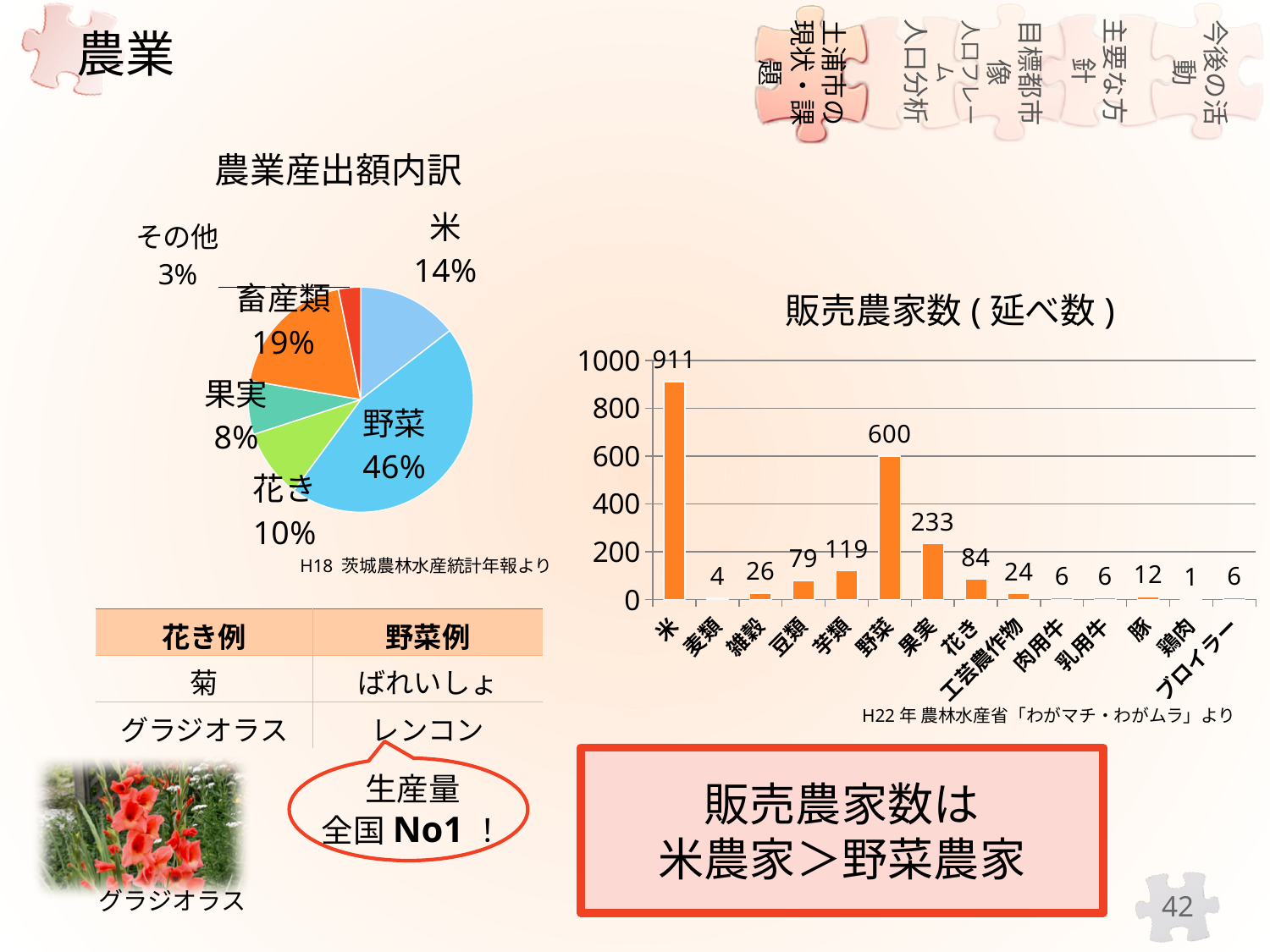
In the bar chart 販売農家数(延べ数), what is the value for 米? 911 In the bar chart 販売農家数(延べ数), which category has the highest value? 米 In the pie chart 農業産出額内訳, how many slices are there? 6 In the pie chart 農業産出額内訳, which category has the smallest share? その他 In the pie chart 農業産出額内訳, what share does 野菜 have? 46% In the pie chart 農業産出額内訳, what is the difference in percentage points between 米 and 果実? 6 In the bar chart 販売農家数(延べ数), which category has the lowest value? 鶏肉 In the bar chart 販売農家数(延べ数), what is the value for 果実? 233 In the bar chart 販売農家数(延べ数), how many categories are shown on the x axis? 14 In the bar chart 販売農家数(延べ数), what is the difference between 米 and 野菜? 311 In the pie chart 農業産出額内訳, what share does 畜産類 have? 19% In the bar chart 販売農家数(延べ数), which is larger, 芋類 or 豆類? 芋類